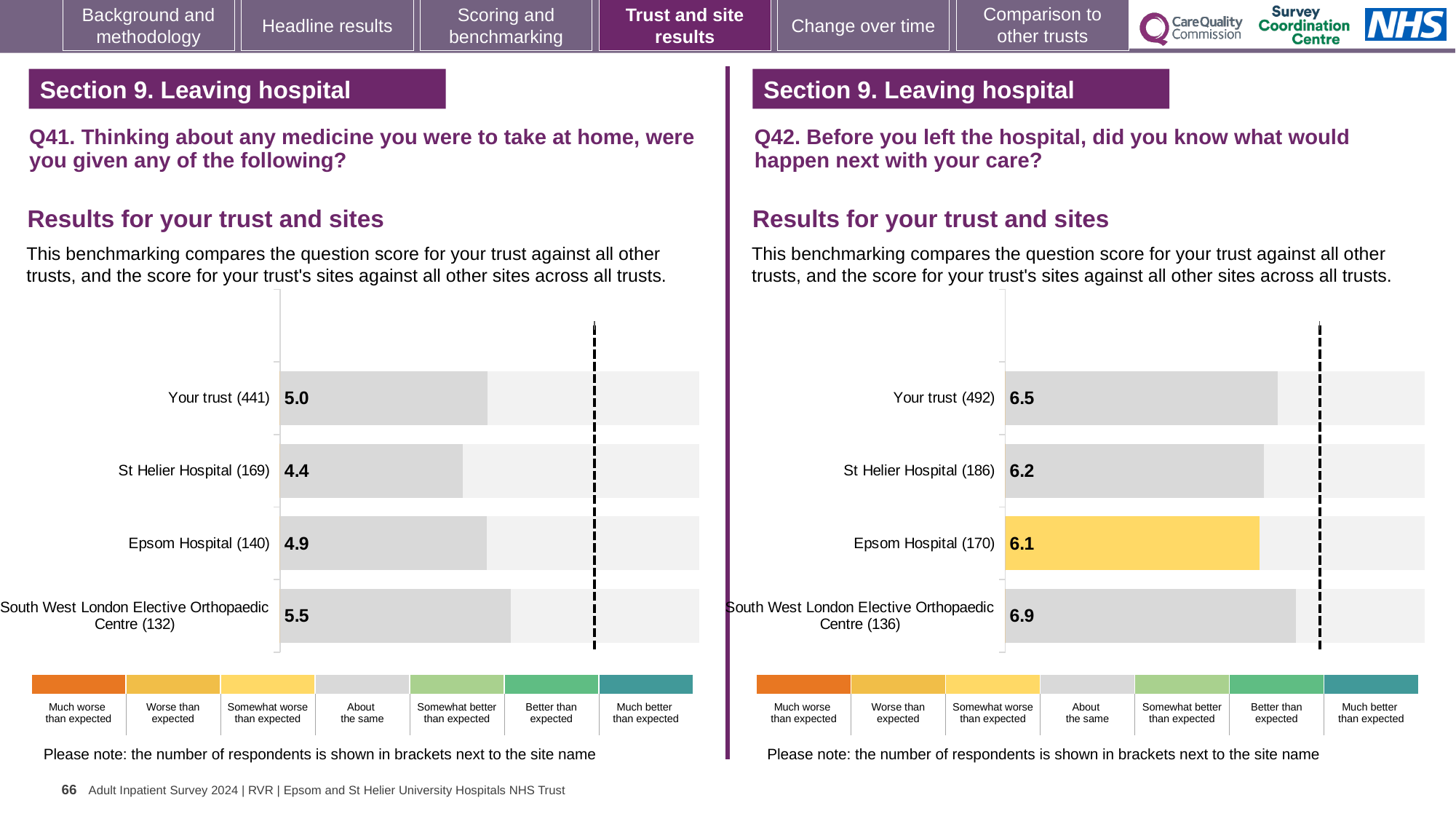
On the Q41 chart (left), what is the score for St Helier Hospital (169)? 4.4 On the Q41 chart (left), what is the score for Your trust (441)? 5.0 On the Q41 chart (left), which site or trust has the highest score? South West London Elective Orthopaedic Centre (132) On the Q42 chart (right), what is the score for South West London Elective Orthopaedic Centre (136)? 6.9 On the Q41 chart (left), which site or trust has the lowest score? St Helier Hospital (169) How many bars are plotted on the Q41 chart (left)? 4 On the Q42 chart (right), which site or trust has the lowest score? Epsom Hospital (170) On the Q42 chart (right), what is the score for Epsom Hospital (170)? 6.1 On the Q42 chart (right), which is larger, the score for Your trust (492) or St Helier Hospital (186)? Your trust (492) On the Q42 chart (right), what is the difference between the scores for Your trust (492) and St Helier Hospital (186)? 0.3 On the Q41 chart (left), what is the difference between the scores for South West London Elective Orthopaedic Centre (132) and Epsom Hospital (140)? 0.6 What type of chart is used for the Q42 results (right)? Bar chart